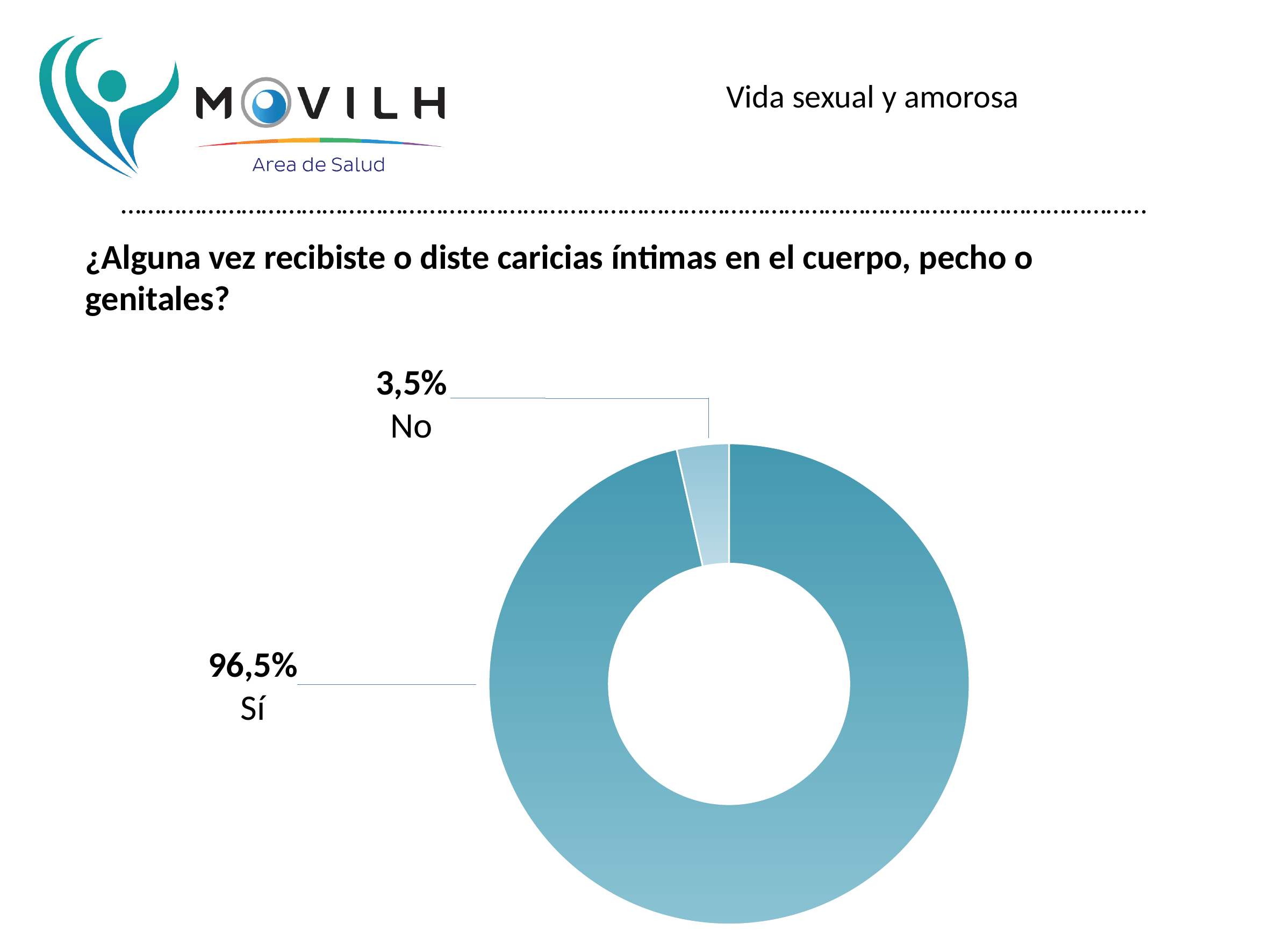
What share of the chart does the "No" slice represent? 3,5% How many categories are shown in the chart? 2 What kind of chart is shown on the slide? Doughnut chart Which category has the largest share of the chart? Sí What is the difference in percentage points between the "Sí" and "No" shares? 93 Which category has the smallest share of the chart? No What percentage of respondents answered "No"? 3,5% What is the total of the two percentages shown in the chart? 100% Which is larger, the share for "Sí" or the share for "No"? Sí What question does the chart on the slide answer? ¿Alguna vez recibiste o diste caricias íntimas en el cuerpo, pecho o genitales? What percentage of respondents answered "Sí"? 96,5% Which slice is shown in the lighter blue colour? No